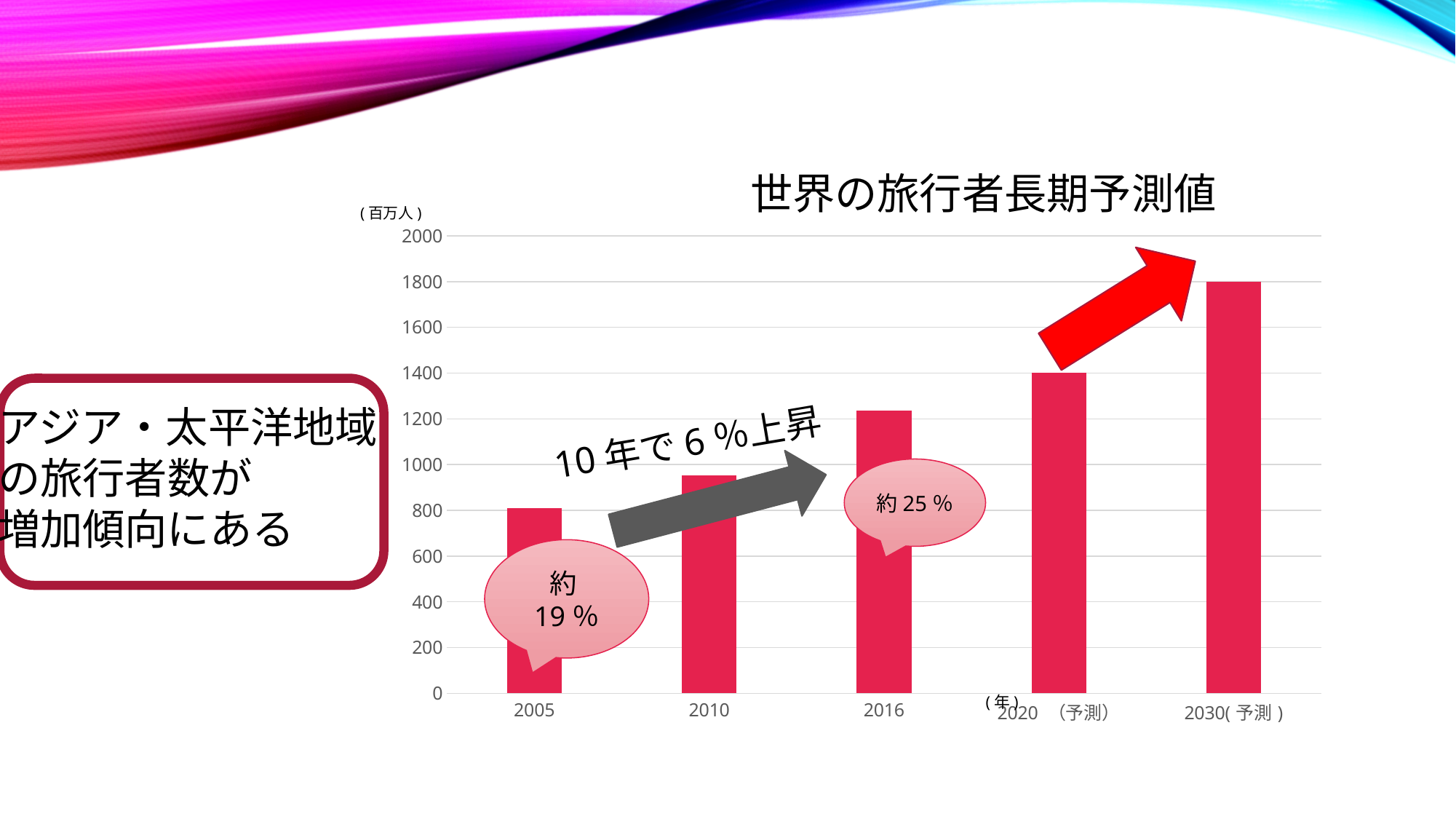
How many bars (categories) are plotted in the chart? 5 Which category has the lowest bar in the chart? 2005 Is the value for 2005 greater or less than 600? greater Is the value for 2005 greater or less than 1000? less What is the title of the chart? 世界の旅行者長期予測値 Which category has the highest bar in the chart? 2030(予測) What kind of chart is shown on the slide? bar chart What unit is shown for the vertical axis of the chart? 百万人 Is the value for 2010 greater or less than 1000? less Which is larger, the value for 2016 or the value for 2010? 2016 Do the values rise or fall from 2005 to 2030(予測) along the x axis? rise